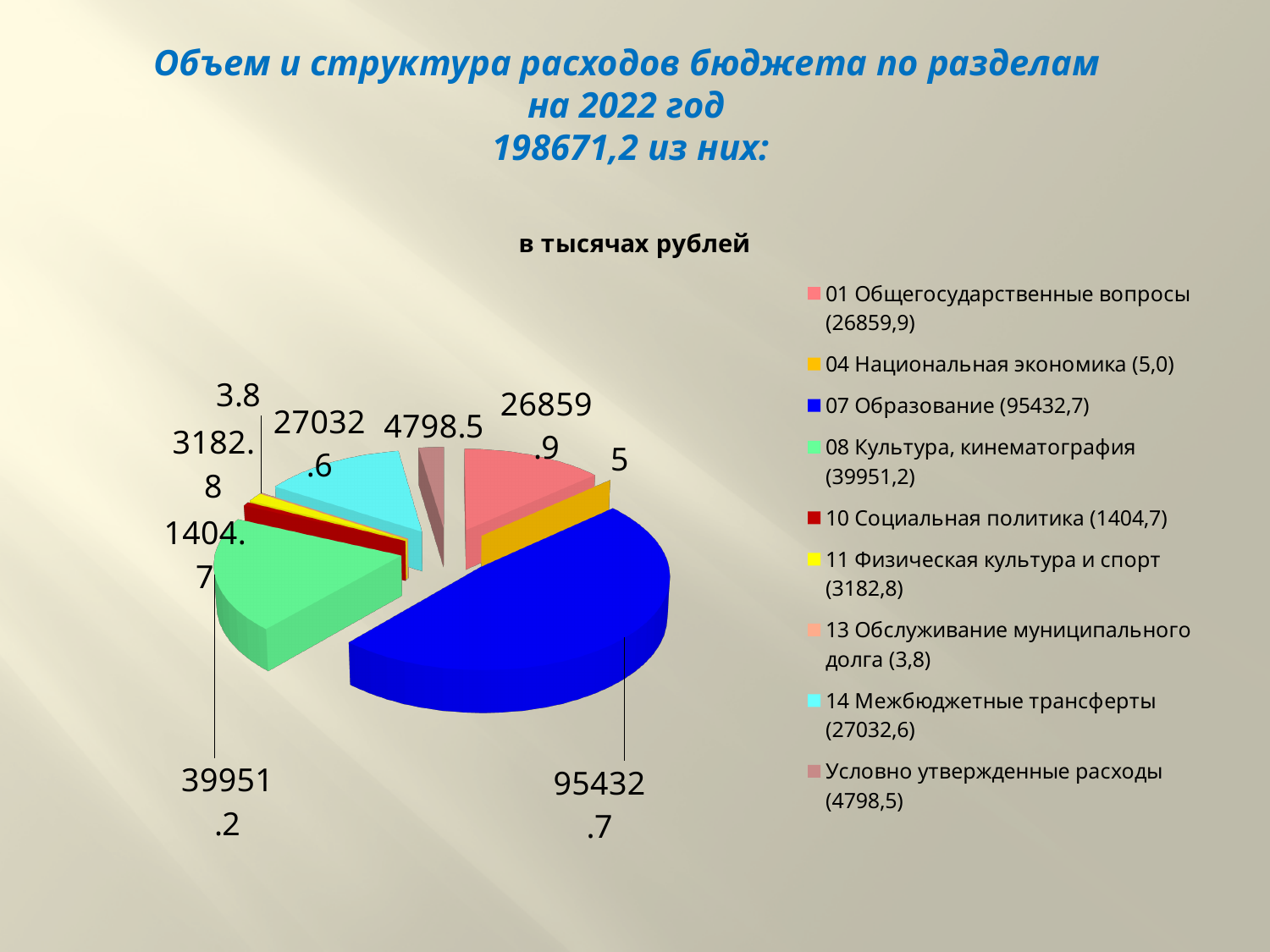
What kind of chart is shown on the slide? pie chart How many categories does the legend list? 9 Which category has the largest slice of the pie? 07 Образование What is the title shown above the pie chart? в тысячах рублей Which category has the smallest slice of the pie? 13 Обслуживание муниципального долга What is the value for 14 Межбюджетные трансферты? 27032.6 What colour is the slice for 10 Социальная политика? dark red Which is larger: the value for 14 Межбюджетные трансферты or the value for 01 Общегосударственные вопросы? 14 Межбюджетные трансферты What is the difference between the values for 07 Образование and 08 Культура, кинематография? 55481.5 What is the value for 08 Культура, кинематография? 39951.2 What is the value for 07 Образование? 95432.7 What is the value for 13 Обслуживание муниципального долга? 3.8